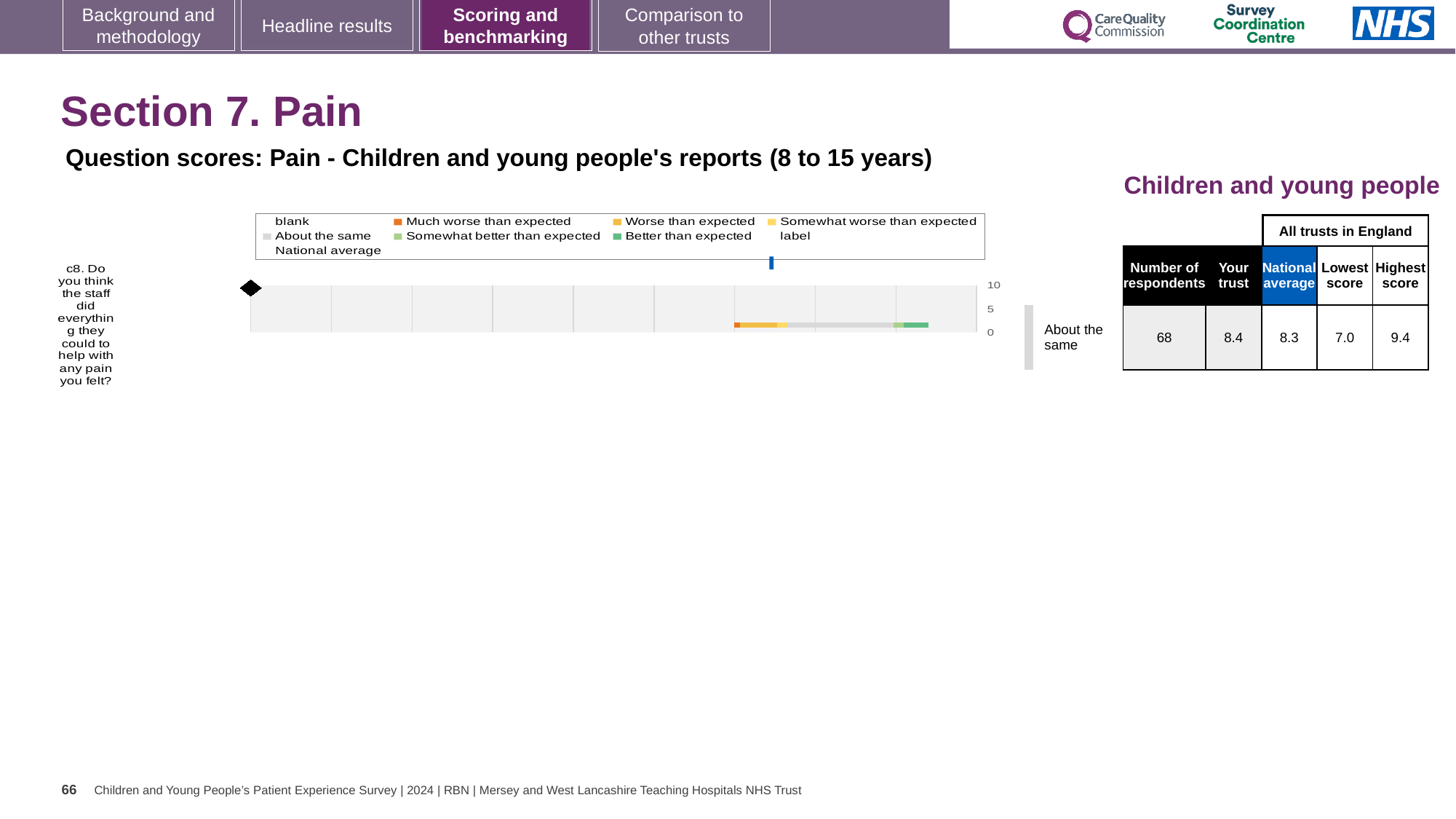
What kind of chart is used to show the question score for c8? bar chart What is the highest score among all trusts in England for question c8? 9.4 Which is larger for question c8: the trust's score or the national average? Your trust (8.4) What is the lowest score among all trusts in England for question c8? 7.0 What is the 'Your trust' score for question c8 about staff helping with pain? 8.4 What benchmark category is the trust's result for question c8 placed in? About the same How many respondents answered question c8? 68 Which legend entry is shown in orange? Much worse than expected What is the difference between the highest and lowest trust scores for question c8? 2.4 What is the national average score for question c8? 8.3 How many survey questions are plotted on the chart? 1